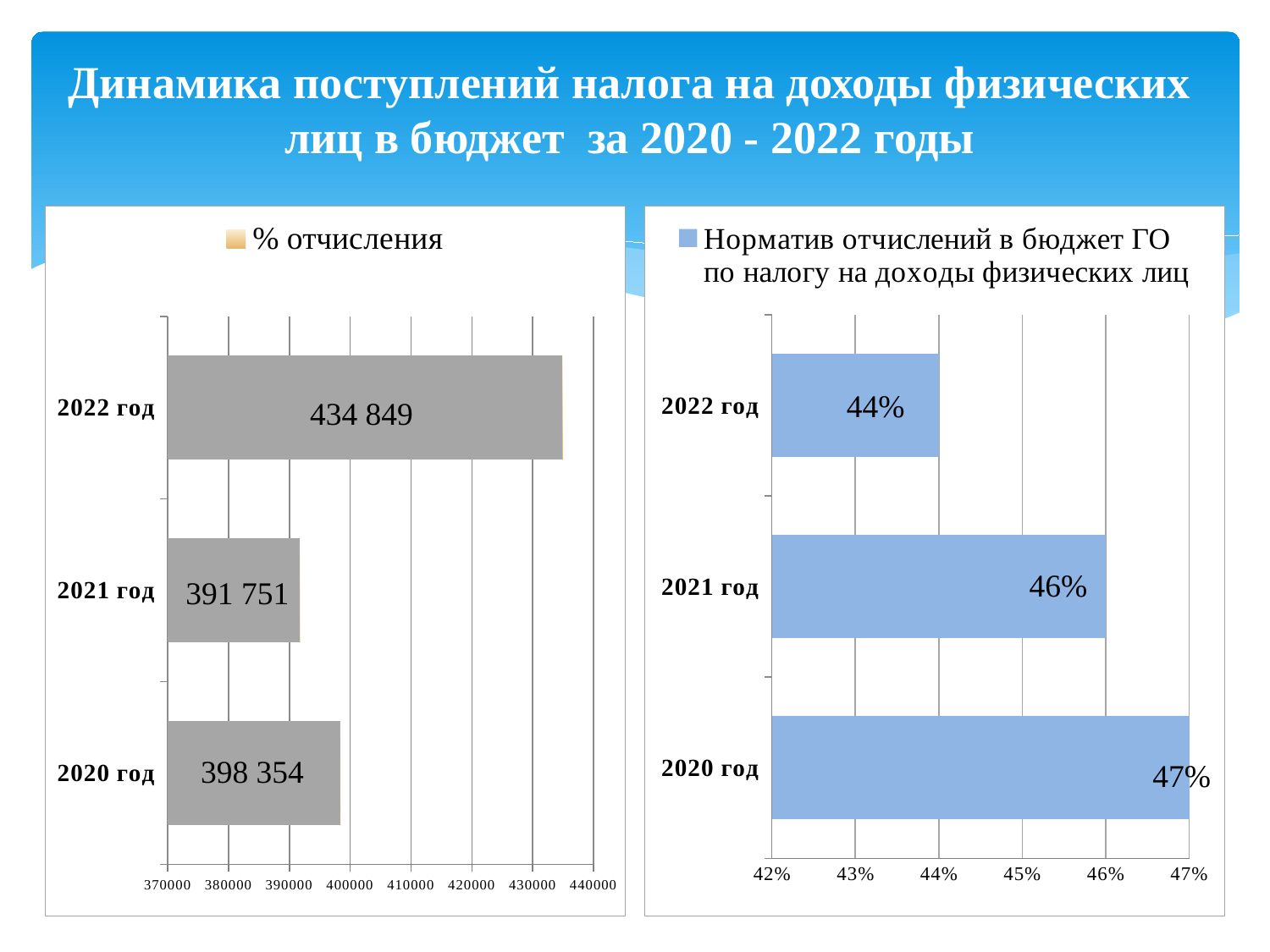
In the left chart (% отчисления), what is the value for 2022 год? 434 849 In the left chart (% отчисления), which year has the lowest value? 2021 год In the right chart (Норматив отчислений в бюджет ГО), what is the difference between the values for 2020 год and 2022 год? 3% In the right chart (Норматив отчислений в бюджет ГО), what is the value for 2021 год? 46% In the left chart (% отчисления), which is larger: the value for 2020 год or 2021 год? 2020 год In the left chart (% отчисления), what is the difference between the values for 2022 год and 2020 год? 36 495 How many categories (years) are shown in the right chart (Норматив отчислений в бюджет ГО)? 3 What type of chart is the left chart (% отчисления)? Bar chart In the left chart (% отчисления), which year has the highest value? 2022 год How many series does the legend of the right chart list? 1 In the right chart (Норматив отчислений в бюджет ГО), which year has the lowest value? 2022 год In the left chart (% отчисления), what is the value for 2021 год? 391 751